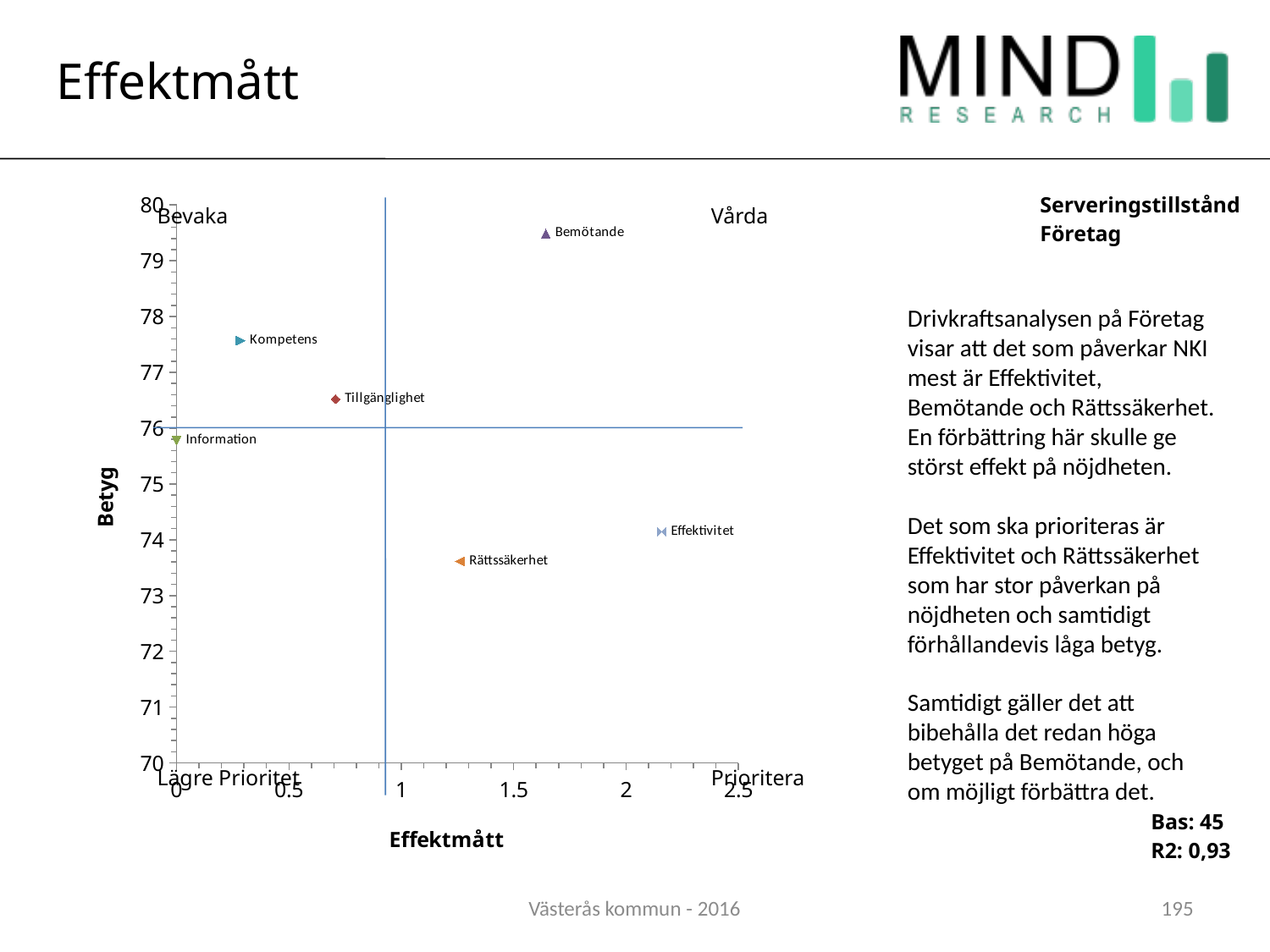
Is the Effektmått value for Effektivitet greater or less than 2? greater Which has a higher Betyg value, Kompetens or Tillgänglighet? Kompetens Which point has the highest Effektmått value? Effektivitet Which point has the highest Betyg value? Bemötande Which point has the lowest Effektmått value? Information Is the Betyg value for Bemötande greater or less than 79? greater Is the Effektmått value for Tillgänglighet greater or less than 1? less What is the title of the vertical axis of the chart? Betyg How many labeled data points are plotted in the chart? 6 Which point has the lowest Betyg value? Rättssäkerhet What kind of chart is shown on the slide? scatter chart